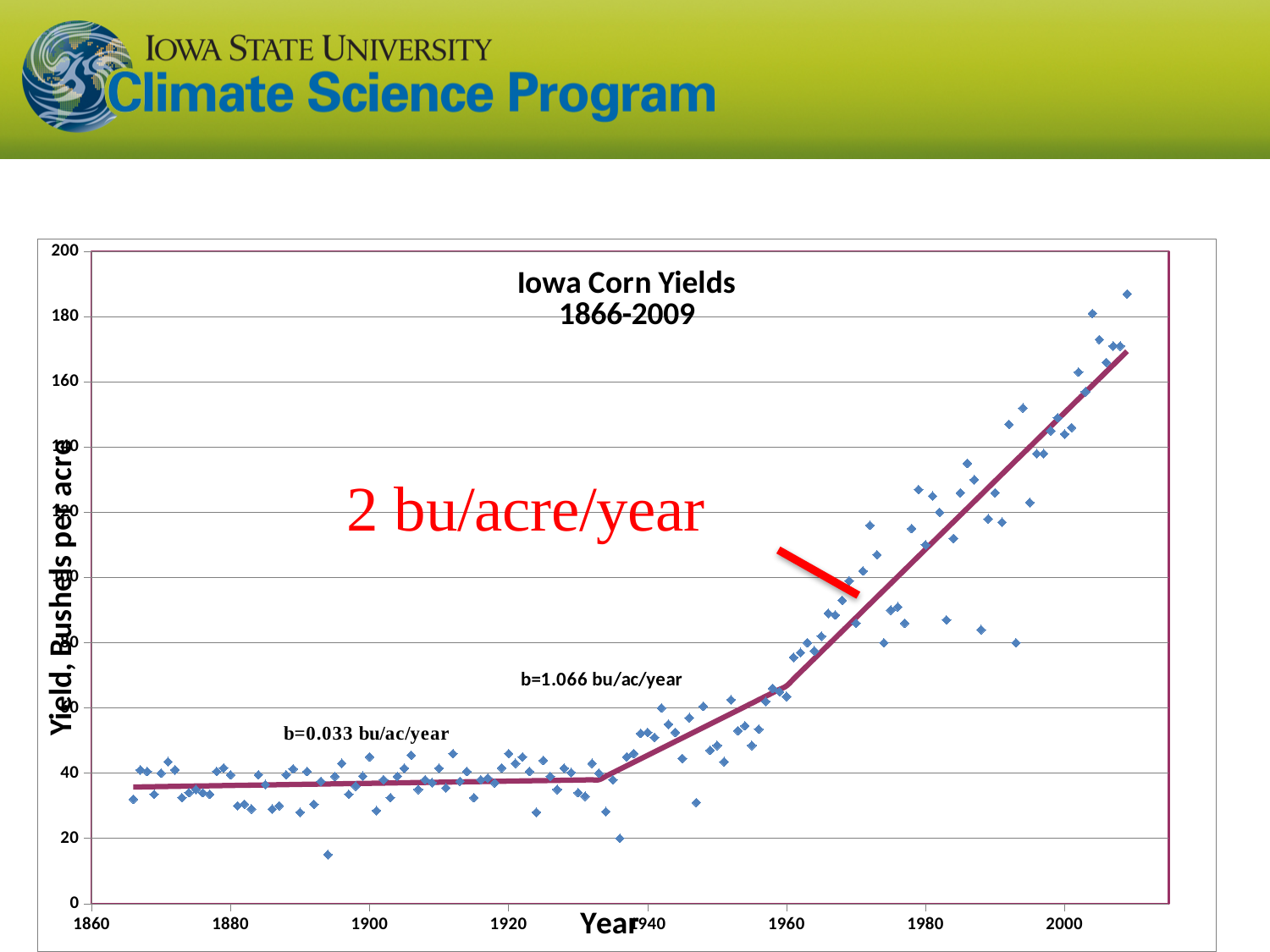
Are all plotted yields before 1920 greater or less than 60 bushels per acre? less What is the title of the chart? Iowa Corn Yields 1866-2009 What is the label of the vertical axis? Yield, Bushels per acre Overall, do Iowa corn yields rise or fall from 1866 to 2009? Rise Is the highest plotted yield on the chart greater or less than 180? greater What rate of yield increase is printed in red for the most recent trend segment? 2 bu/acre/year Which period has higher yields: the years around 1880 or the years around 2000? Around 2000 What kind of chart is shown on the slide? Scatter chart What is the maximum value shown on the vertical axis? 200 What slope (b) is printed for the middle trend segment of the chart? b=1.066 bu/ac/year What slope (b) is printed for the earliest trend segment of the chart? b=0.033 bu/ac/year Is the lowest plotted yield on the chart greater or less than 20? less